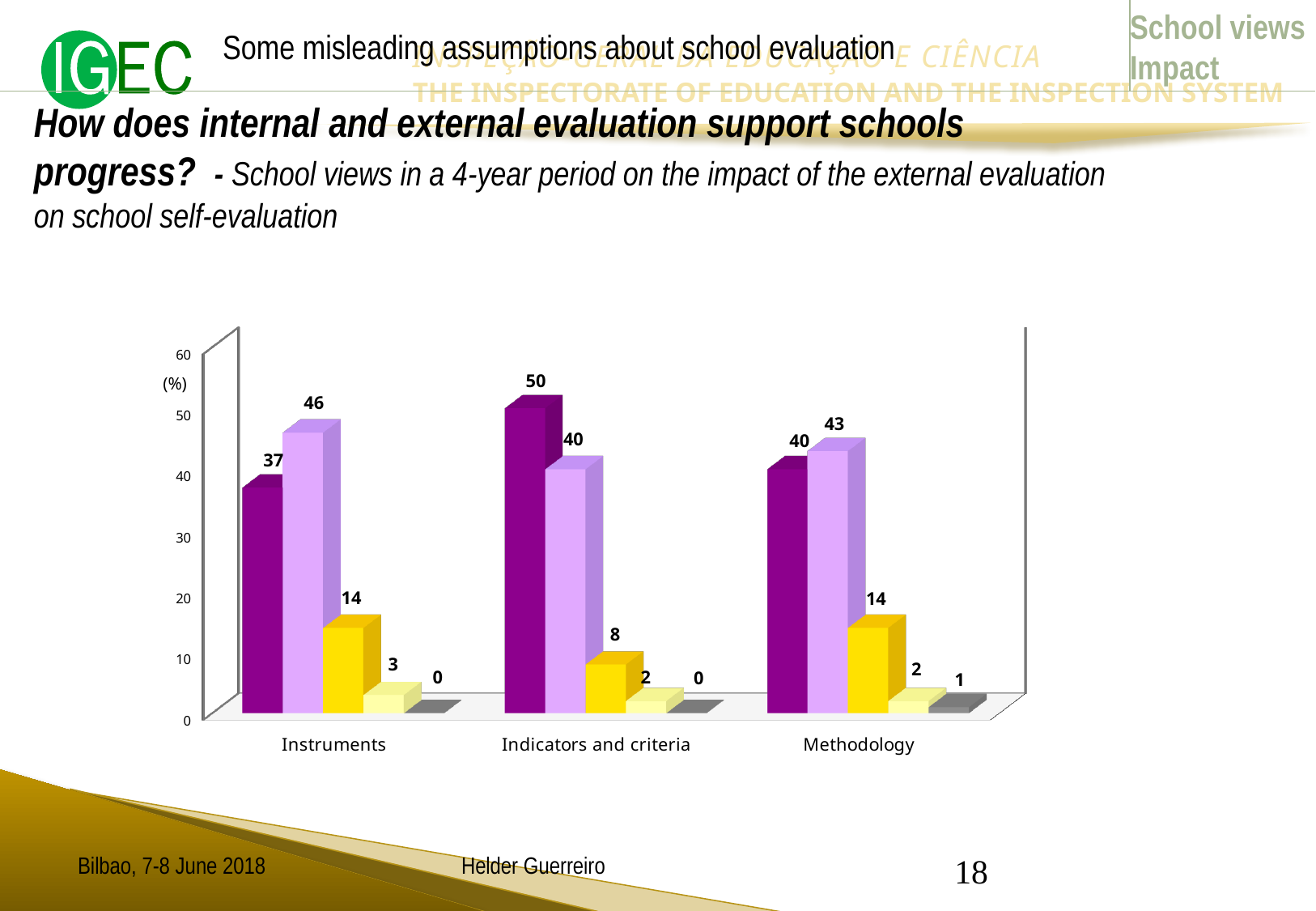
What is the value of the tallest bar in the Instruments category? 46 Which is larger: the dark purple bar for Instruments or the dark purple bar for Methodology? Methodology What is the value of the tallest bar in the Indicators and criteria category? 50 What type of chart is shown on the slide? bar chart What is the value of the yellow bar for Indicators and criteria? 8 Which category has the highest single bar value in the chart? Indicators and criteria What unit is shown on the vertical axis of the chart? (%) What is the difference between the yellow bar for Instruments and the yellow bar for Indicators and criteria? 6 How many categories are shown on the x axis of the chart? 3 What is the value of the dark purple bar for Methodology? 40 What is the value of the grey bar for Methodology? 1 What is the difference between the two tallest bars in the Indicators and criteria category (50 and 40)? 10